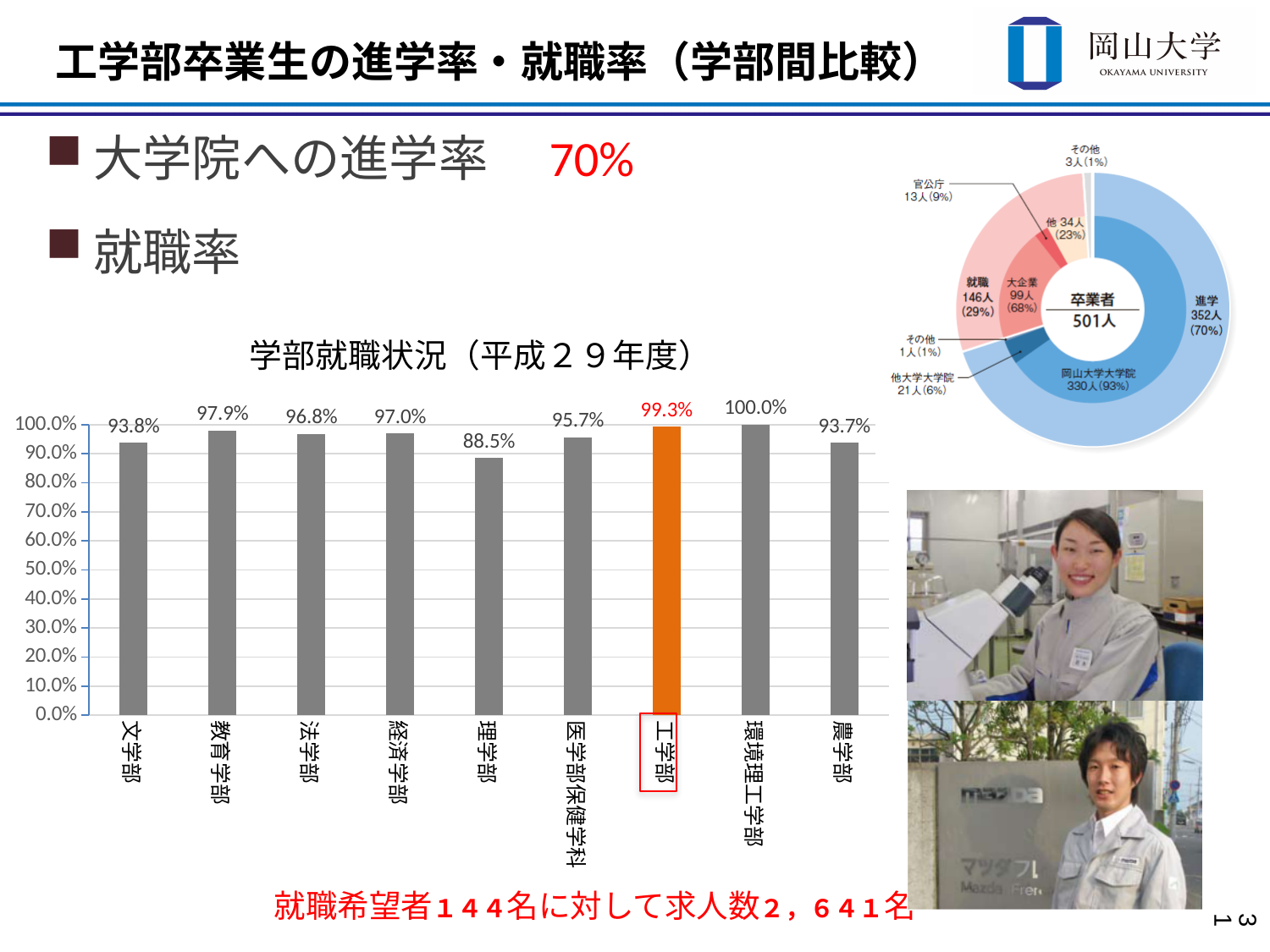
In the bar chart titled 学部就職状況（平成２９年度）, which faculty has the highest value? 環境理工学部 What kind of chart is the chart titled 学部就職状況（平成２９年度）? bar chart In the bar chart titled 学部就職状況（平成２９年度）, what is the value for 教育学部? 97.9% How many faculties are shown in the bar chart titled 学部就職状況（平成２９年度）? 9 In the donut chart at the top right of the slide, how many graduates (卒業者) are shown in the centre? 501人 In the bar chart titled 学部就職状況（平成２９年度）, what is the value for 工学部? 99.3% In the bar chart titled 学部就職状況（平成２９年度）, what is the difference between the values for 環境理工学部 and 理学部? 11.5% In the bar chart titled 学部就職状況（平成２９年度）, what is the value for 理学部? 88.5% In the bar chart titled 学部就職状況（平成２９年度）, which faculty has the lowest value? 理学部 In the bar chart titled 学部就職状況（平成２９年度）, which is larger, the value for 法学部 or the value for 経済学部? 経済学部 In the bar chart titled 学部就職状況（平成２９年度）, is the value for 理学部 greater or less than 90.0%? less In the bar chart titled 学部就職状況（平成２９年度）, which bar is coloured orange instead of grey? 工学部